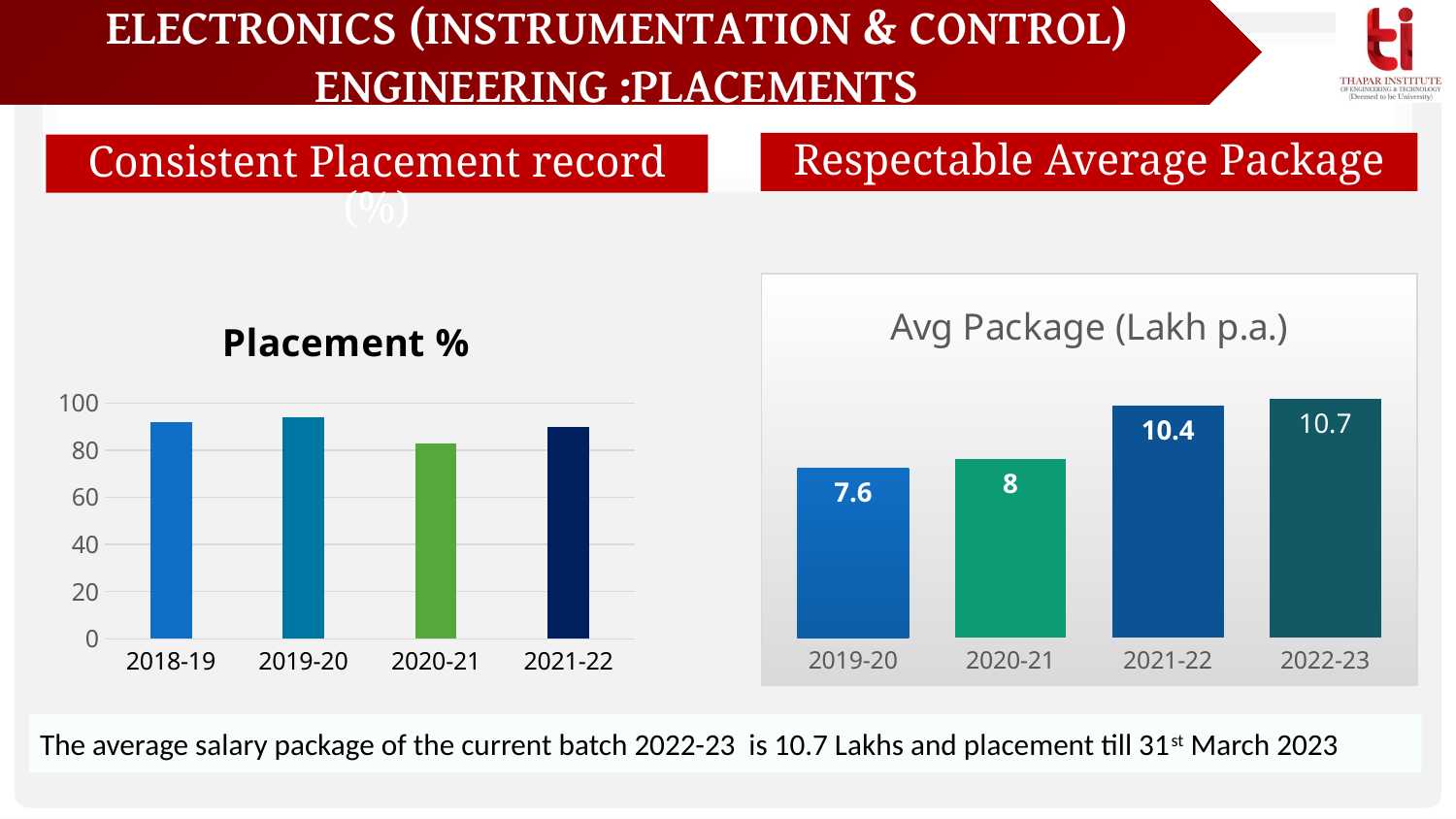
In the Avg Package (Lakh p.a.) chart, do the values rise or fall from 2019-20 to 2022-23? rise In the Avg Package (Lakh p.a.) chart, which year has the highest value? 2022-23 How many years are shown in the Placement % chart? 4 In the Avg Package (Lakh p.a.) chart, what is the value for 2019-20? 7.6 In the Placement % chart, which year has the lowest value? 2020-21 In the Placement % chart, is the value for 2021-22 greater or less than 100? less In the Avg Package (Lakh p.a.) chart, what is the value for 2022-23? 10.7 In the Avg Package (Lakh p.a.) chart, which year has the lowest value? 2019-20 In the Avg Package (Lakh p.a.) chart, what is the difference between the values for 2021-22 and 2020-21? 2.4 What kind of chart is the Avg Package (Lakh p.a.) chart? bar chart In the Placement % chart, is the value for 2018-19 greater or less than 80? greater In the Avg Package (Lakh p.a.) chart, what is the value for 2021-22? 10.4